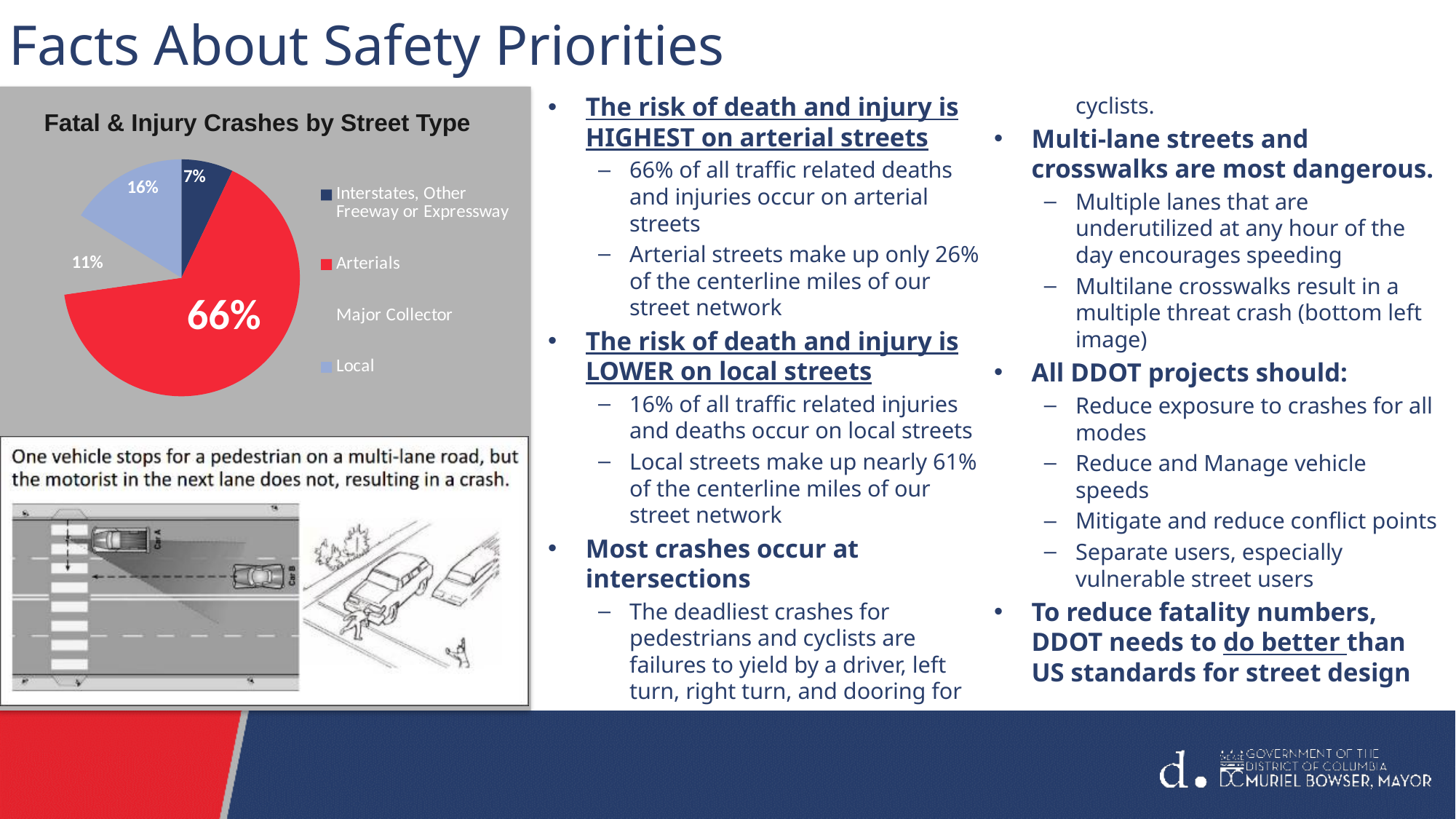
How many street type categories does the pie chart show? 4 What type of chart is shown on the slide? pie chart What is the title of the chart? Fatal & Injury Crashes by Street Type What share of fatal and injury crashes occur on Local streets? 16% Which street type has the largest share of fatal and injury crashes? Arterials How many percentage points larger is the Arterials share than the Local share? 50 Which has a larger share of fatal and injury crashes, Local or Major Collector? Local What colour is the Arterials slice in the pie chart? red Which street type has the smallest share of fatal and injury crashes? Interstates, Other Freeway or Expressway What share of fatal and injury crashes occur on Interstates, Other Freeway or Expressway? 7% What share of fatal and injury crashes occur on Arterials? 66% What share of fatal and injury crashes occur on Major Collector streets? 11%